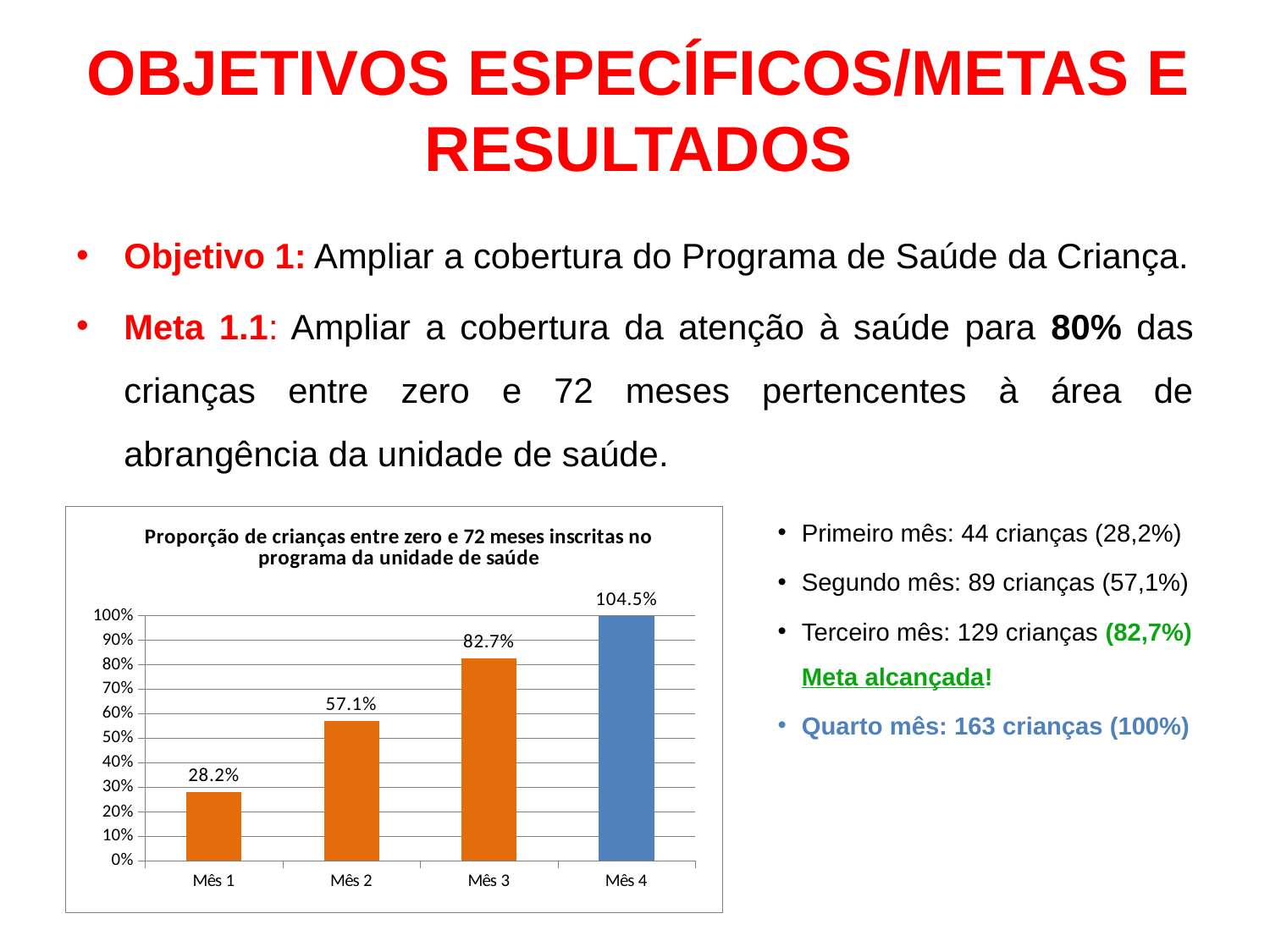
Which bar is coloured differently (blue) from the others? Mês 4 Which month has the highest value? Mês 4 Which is larger, the value for Mês 2 or the value for Mês 3? Mês 3 What is the value for Mês 3? 82.7% What type of chart is shown on the slide? bar chart What is the value for Mês 1? 28.2% What is the value for Mês 2? 57.1% Which month has the lowest value? Mês 1 Do the values rise or fall from Mês 1 to Mês 4? rise What is the value for Mês 4? 104.5% How many months (categories) are shown on the x axis? 4 What is the difference between the values for Mês 3 and Mês 2? 25.6%